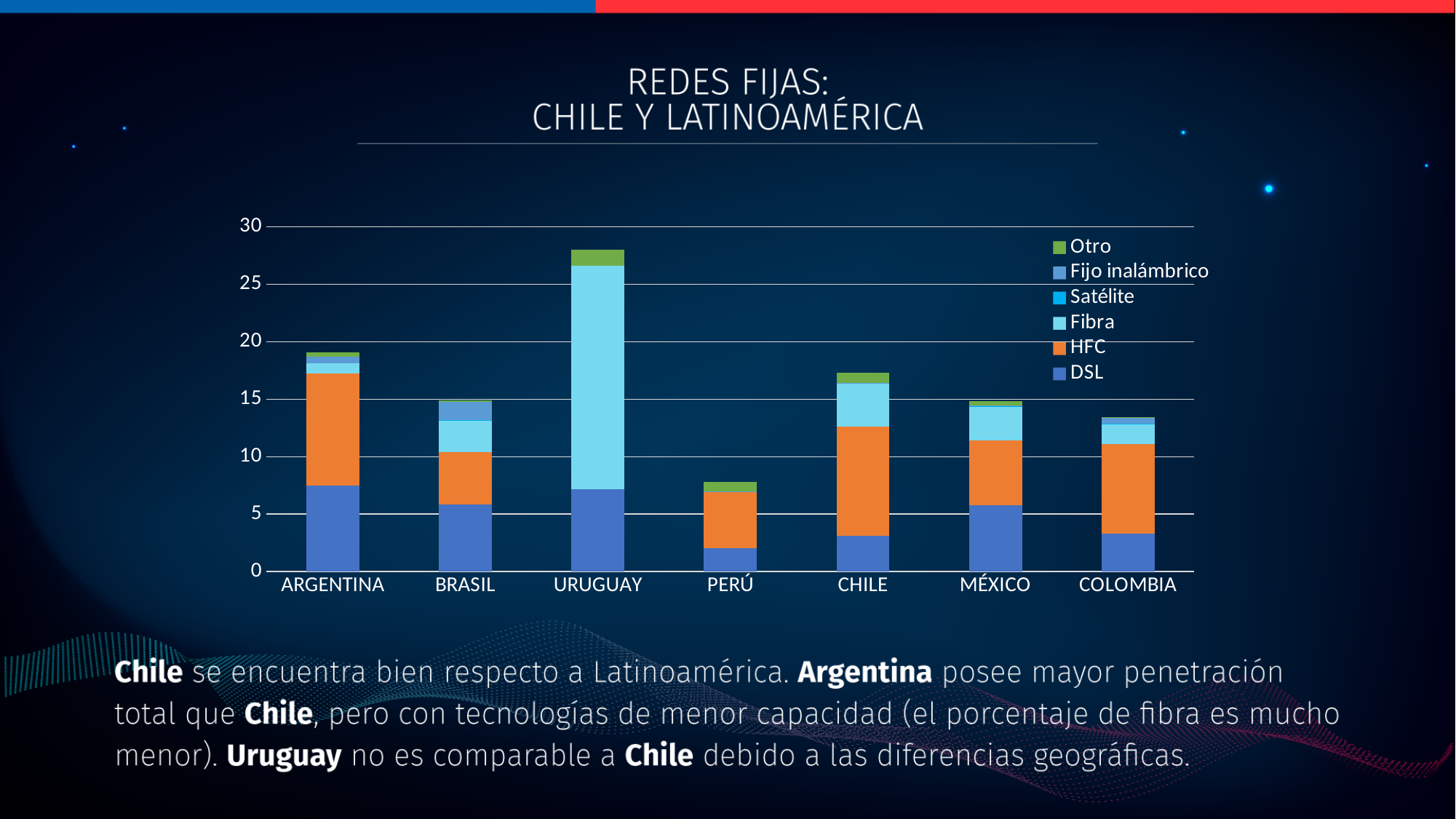
Is the total value for Uruguay greater or less than 25? greater What kind of chart is shown on the slide? Stacked bar chart How many series does the chart's legend list? 6 Which has the larger total bar, Argentina or Chile? Argentina Which country has the lowest total bar in the chart? Perú How many countries are shown on the x axis of the chart? 7 Is the total value for Argentina greater or less than 20? less Which country has the highest total bar in the chart? Uruguay Is the total value for Chile greater or less than 15? greater Which country has the largest Fibra segment in the chart? Uruguay What is the title of the chart on the slide? REDES FIJAS: CHILE Y LATINOAMÉRICA